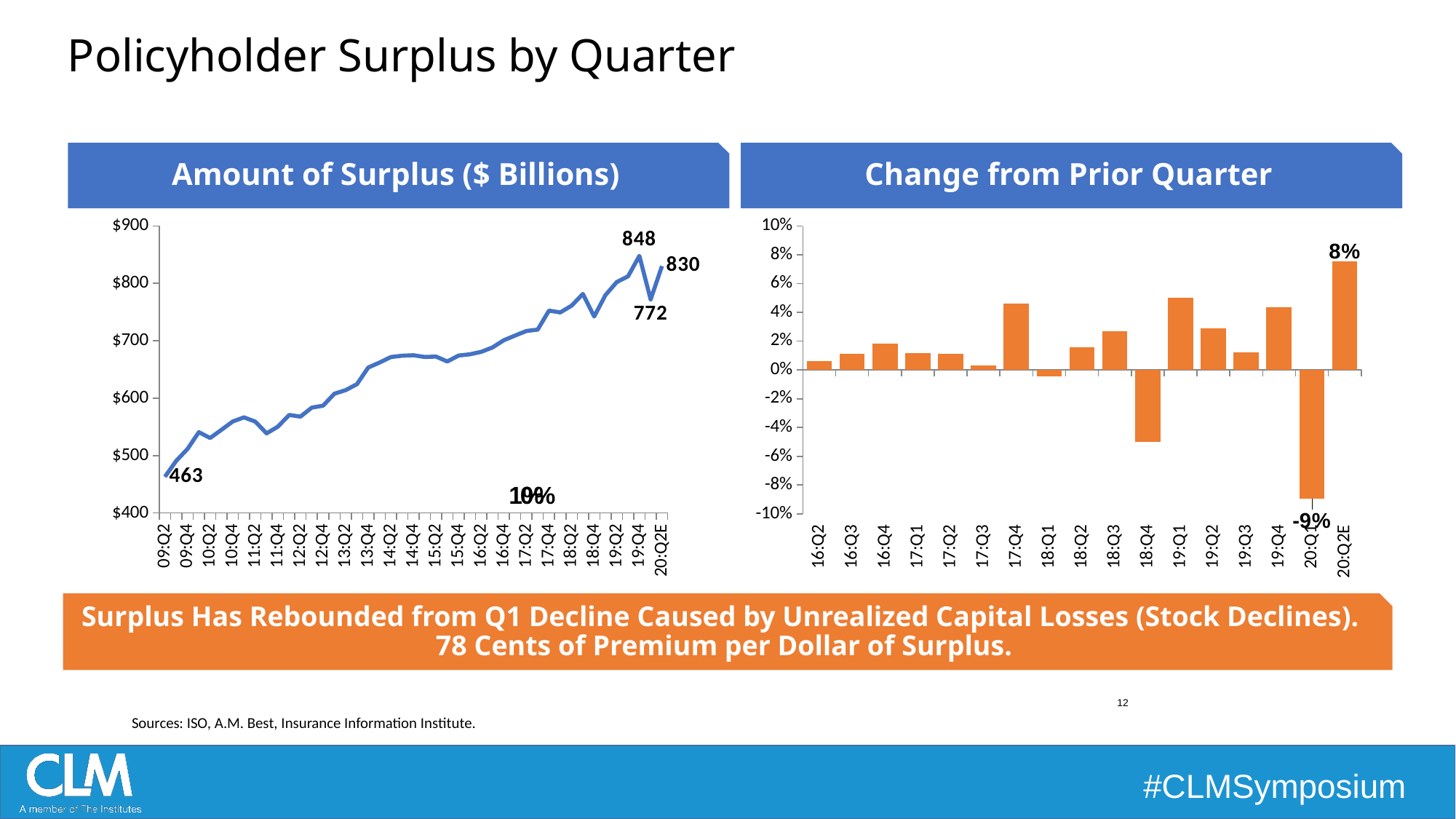
How many quarters are shown on the x axis of the 'Change from Prior Quarter' chart? 17 In the 'Amount of Surplus ($ Billions)' chart, what is the value for 09:Q2? 463 In the 'Change from Prior Quarter' chart, which quarter has the lowest value? 20:Q1 In the 'Change from Prior Quarter' chart, what is the value for 20:Q2E? 8% In the 'Amount of Surplus ($ Billions)' chart, does the surplus generally rise or fall from 09:Q2 to 20:Q2E? rise What kind of chart is the 'Amount of Surplus ($ Billions)' chart on the left? line chart In the 'Amount of Surplus ($ Billions)' chart, what is the difference between the 19:Q4 value and the 20:Q1 value? 76 In the 'Amount of Surplus ($ Billions)' chart, what is the value for 19:Q4? 848 In the 'Change from Prior Quarter' chart, what is the value for 20:Q1? -9% In the 'Amount of Surplus ($ Billions)' chart, what is the value for 20:Q2E? 830 What kind of chart is the 'Change from Prior Quarter' chart on the right? bar chart In the 'Amount of Surplus ($ Billions)' chart, what is the value for 20:Q1? 772